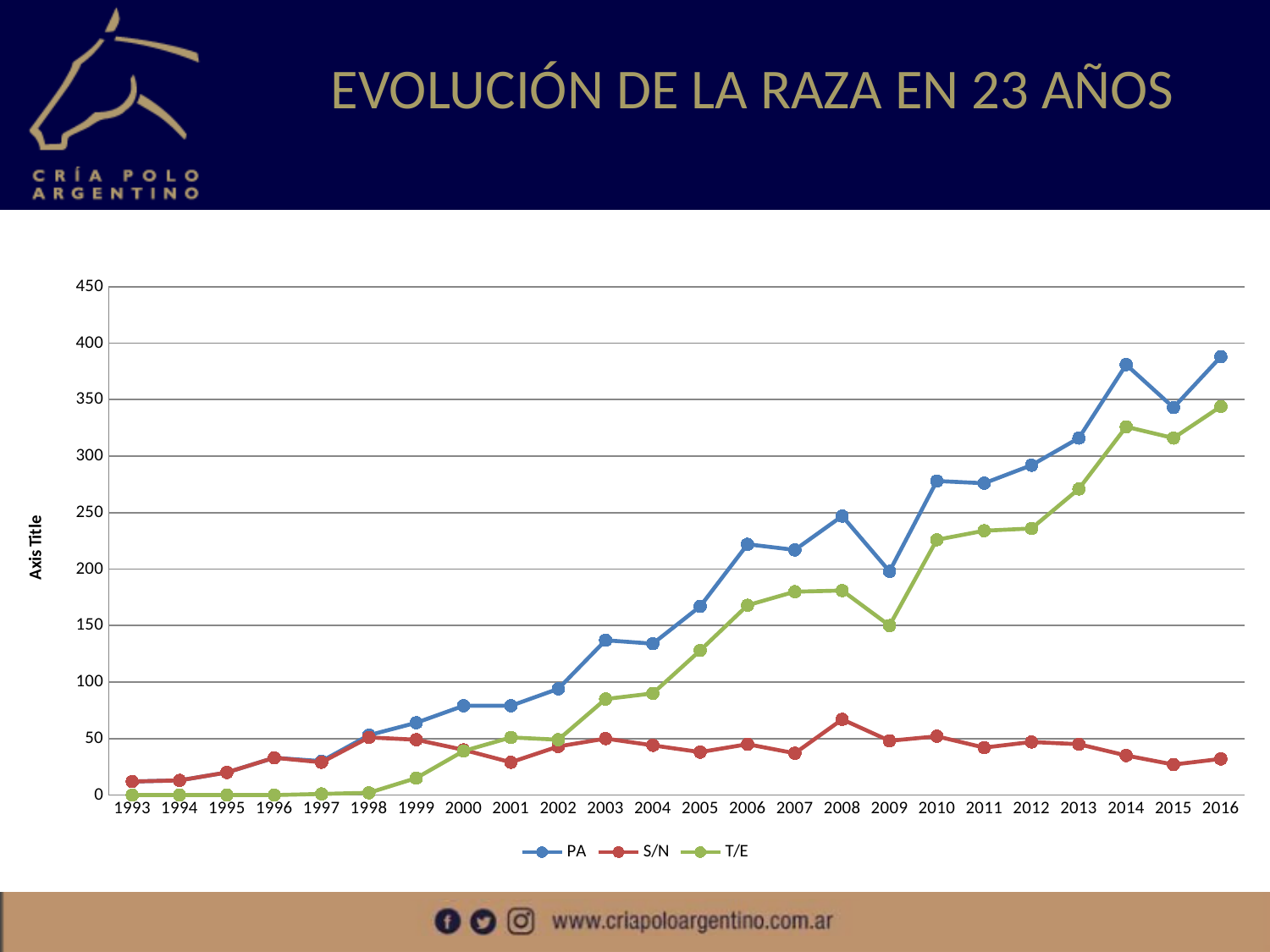
Is the value for PA in 2016 greater or less than 350? greater Does the PA series generally rise or fall from 1993 to 2016? rise Which series has the larger value in 2016, PA or T/E? PA How many series does the legend list? 3 Which series is drawn in red? S/N In which year is the PA series at its lowest? 1993 Is the value for T/E in 2009 greater or less than 200? less In which year does the S/N series reach its highest value? 2008 What kind of chart is shown on the slide? line chart How many years are plotted along the x axis? 24 In which year does the PA series reach its highest value? 2016 What is the title of the chart? EVOLUCIÓN DE LA RAZA EN 23 AÑOS